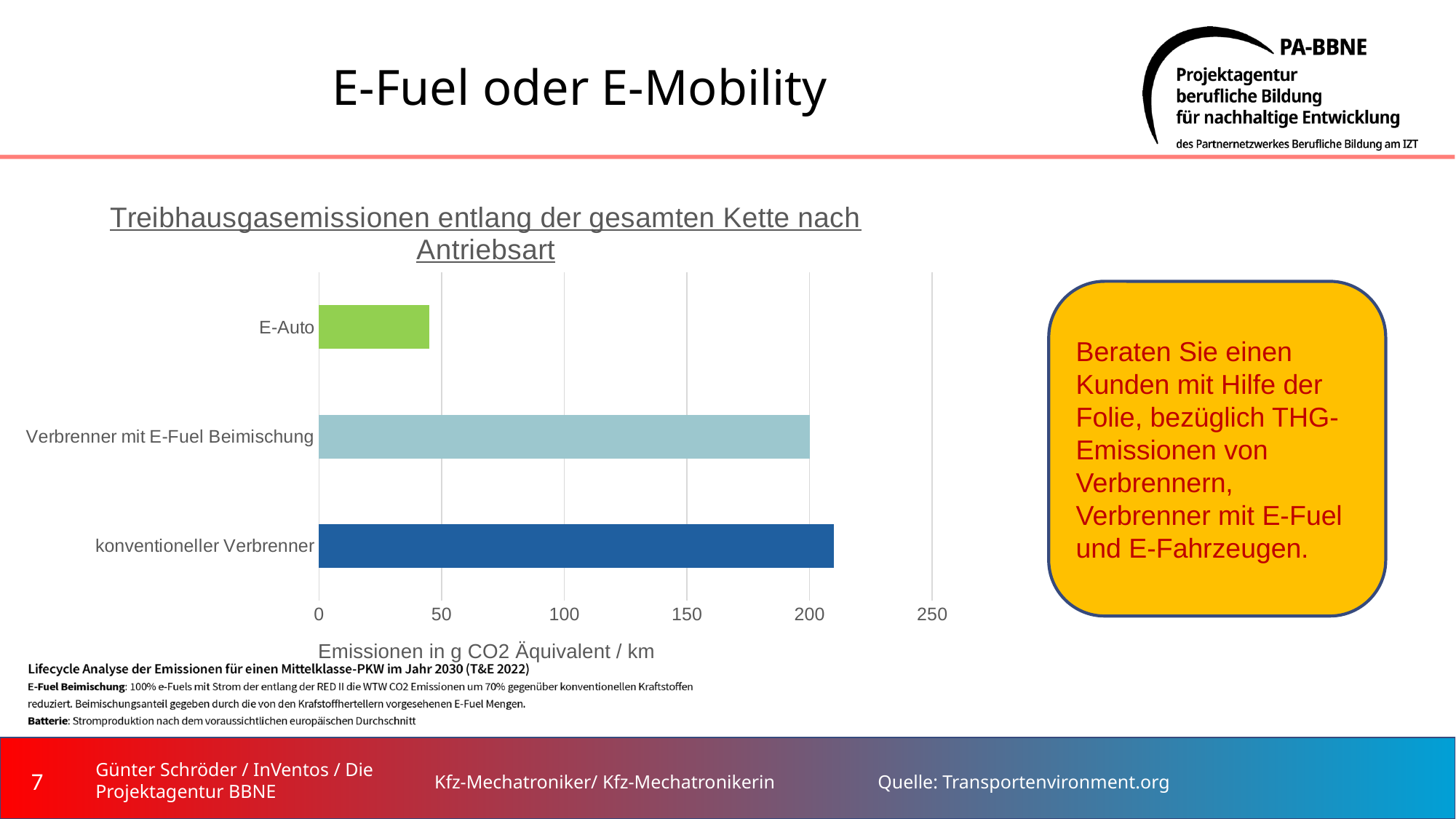
Is the value for E-Auto greater or less than 50? less What is the title of the chart? Treibhausgasemissionen entlang der gesamten Kette nach Antriebsart Which has higher emissions, konventioneller Verbrenner or E-Auto? konventioneller Verbrenner Is the value for Verbrenner mit E-Fuel Beimischung greater or less than 150? greater What is the value for Verbrenner mit E-Fuel Beimischung in g CO2 Äquivalent / km? 200 Which category has the highest emissions in the chart? konventioneller Verbrenner What is the label of the horizontal axis of the chart? Emissionen in g CO2 Äquivalent / km What kind of chart is shown on the slide? bar chart Which category has the lowest emissions in the chart? E-Auto Is the value for konventioneller Verbrenner greater or less than 200? greater Which has higher emissions, E-Auto or Verbrenner mit E-Fuel Beimischung? Verbrenner mit E-Fuel Beimischung How many categories (drive types) are shown in the chart? 3